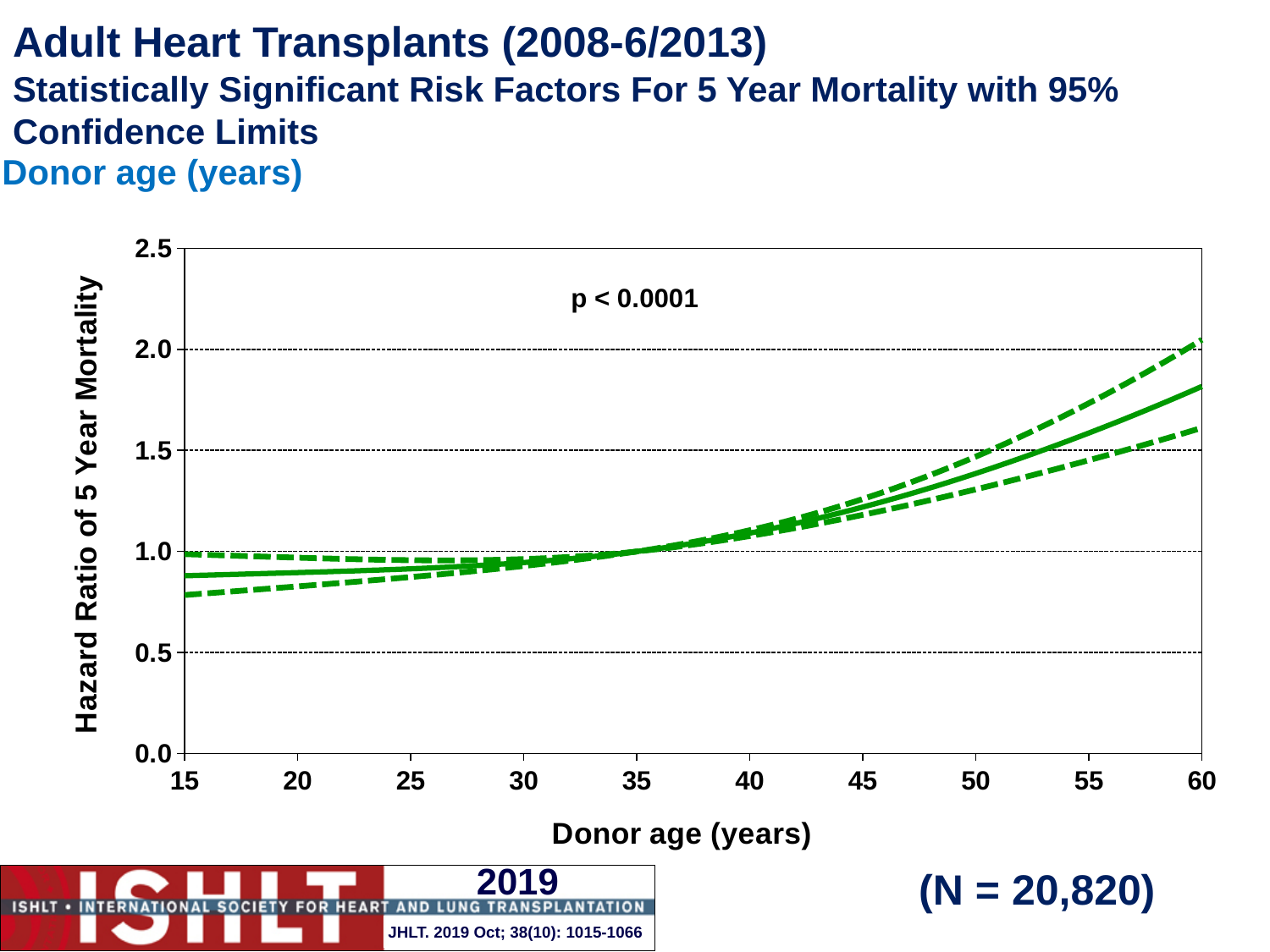
What p-value is printed on the chart? p < 0.0001 What kind of chart is shown on the slide? line chart Is the hazard ratio on the solid line at a donor age of 25 years greater or less than 1.5? less Is the hazard ratio on the solid line at a donor age of 50 years greater or less than 1.0? greater Is the hazard ratio on the solid line at a donor age of 15 years greater or less than 1.0? less Does the hazard ratio of 5 year mortality rise or fall as donor age increases from 15 to 60 years? rise Is the hazard ratio on the solid line higher at a donor age of 60 years or at a donor age of 15 years? 60 years How many lines are plotted on the chart? 3 What is the label of the x axis of the chart? Donor age (years)